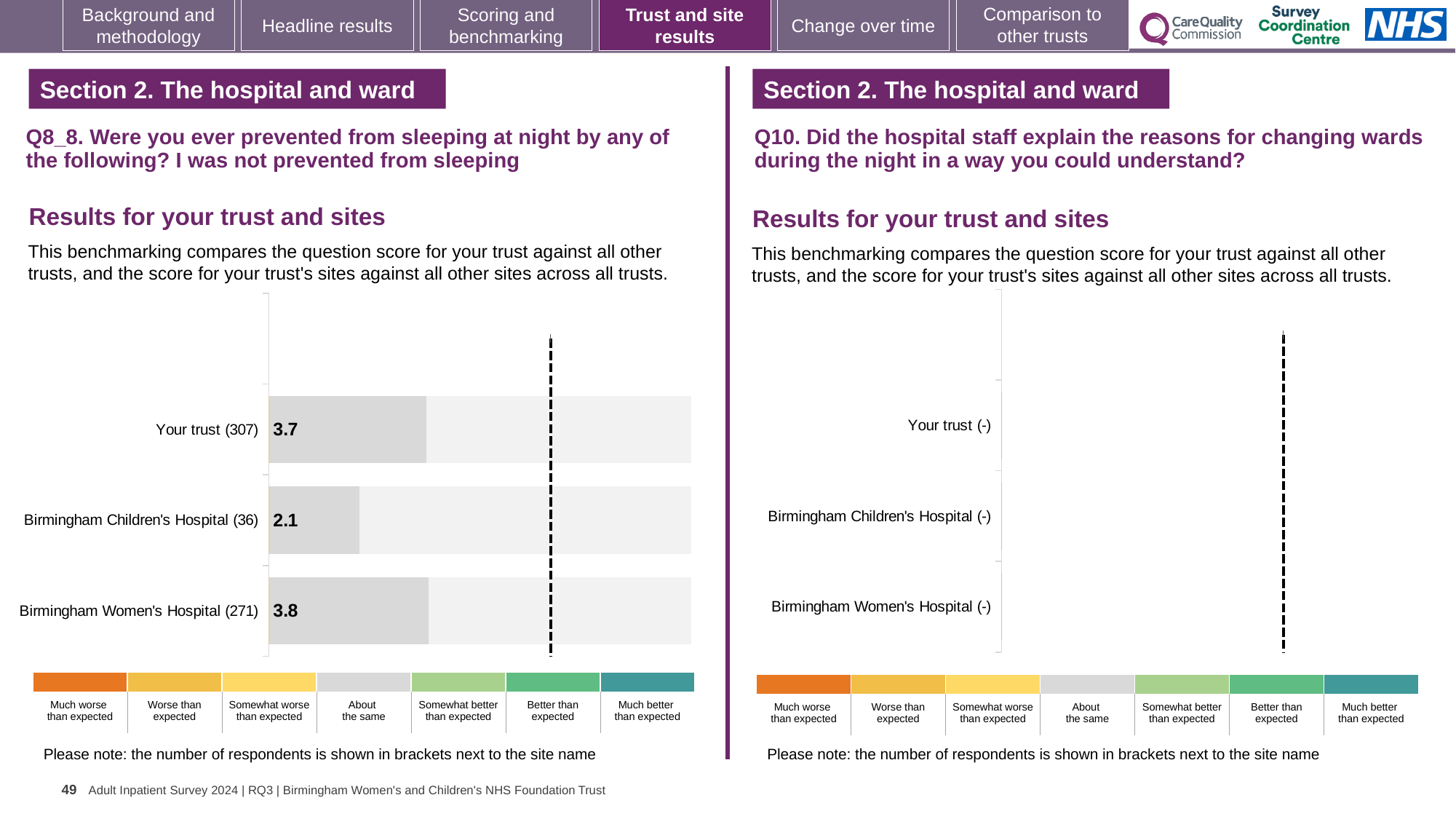
In the left chart (Q8_8), how many respondents are shown in brackets for Your trust? 307 How many bars are plotted in the left chart (Q8_8)? 3 In the left chart (Q8_8), which site or trust has the lowest score? Birmingham Children's Hospital In the right chart (Q10), what is shown in brackets next to each site name instead of a number of respondents? - In the left chart (Q8_8), which has the larger score, Your trust or Birmingham Children's Hospital? Your trust In the left chart (Q8_8), which site or trust has the highest score? Birmingham Women's Hospital What kind of chart is the left chart (Q8_8)? Bar chart In the left chart (Q8_8), what is the difference between the scores for Your trust and Birmingham Children's Hospital? 1.6 In the left chart (Q8_8), what is the difference between the scores for Birmingham Women's Hospital and Birmingham Children's Hospital? 1.7 In the left chart (Q8_8), what is the score for Your trust? 3.7 In the left chart (Q8_8), what is the score for Birmingham Women's Hospital? 3.8 In the left chart (Q8_8), what is the score for Birmingham Children's Hospital? 2.1